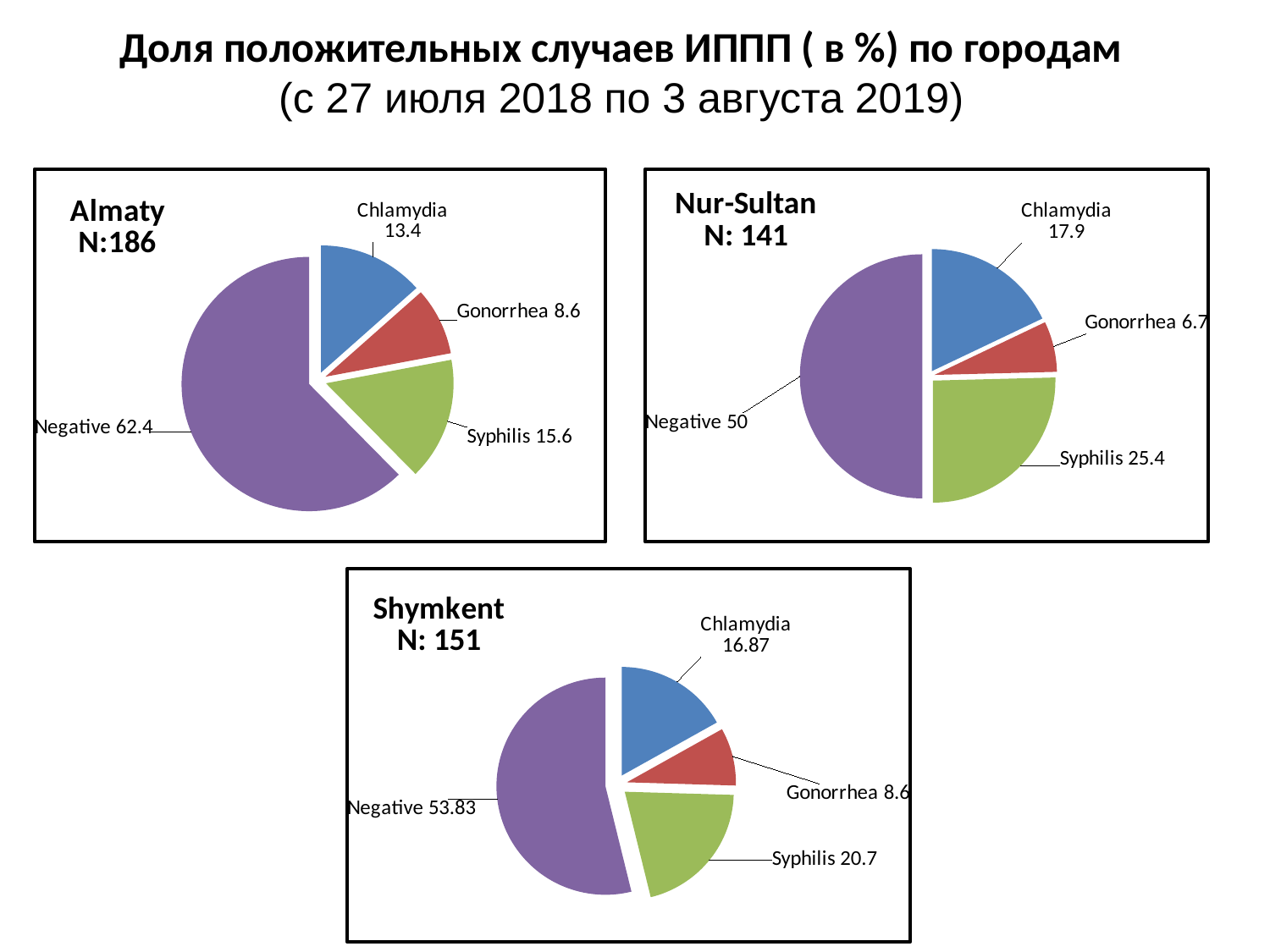
In the Nur-Sultan pie chart, what is the value for Chlamydia? 17.9 In the Nur-Sultan pie chart, what is the difference between Syphilis and Chlamydia? 7.5 In the Almaty pie chart, what is the difference between Negative and Syphilis? 46.8 What type of chart is used for Nur-Sultan? Pie chart What is the N value shown for the Almaty chart? 186 In the Almaty pie chart, which category has the largest slice? Negative In the Shymkent pie chart, which is larger, Chlamydia or Syphilis? Syphilis In the Nur-Sultan pie chart, which category has the smallest slice? Gonorrhea In the Almaty pie chart, what is the value for Syphilis? 15.6 How many slices does the Shymkent pie chart have? 4 In the Nur-Sultan pie chart, what is the value for Gonorrhea? 6.7 In the Shymkent pie chart, what is the value for Negative? 53.83